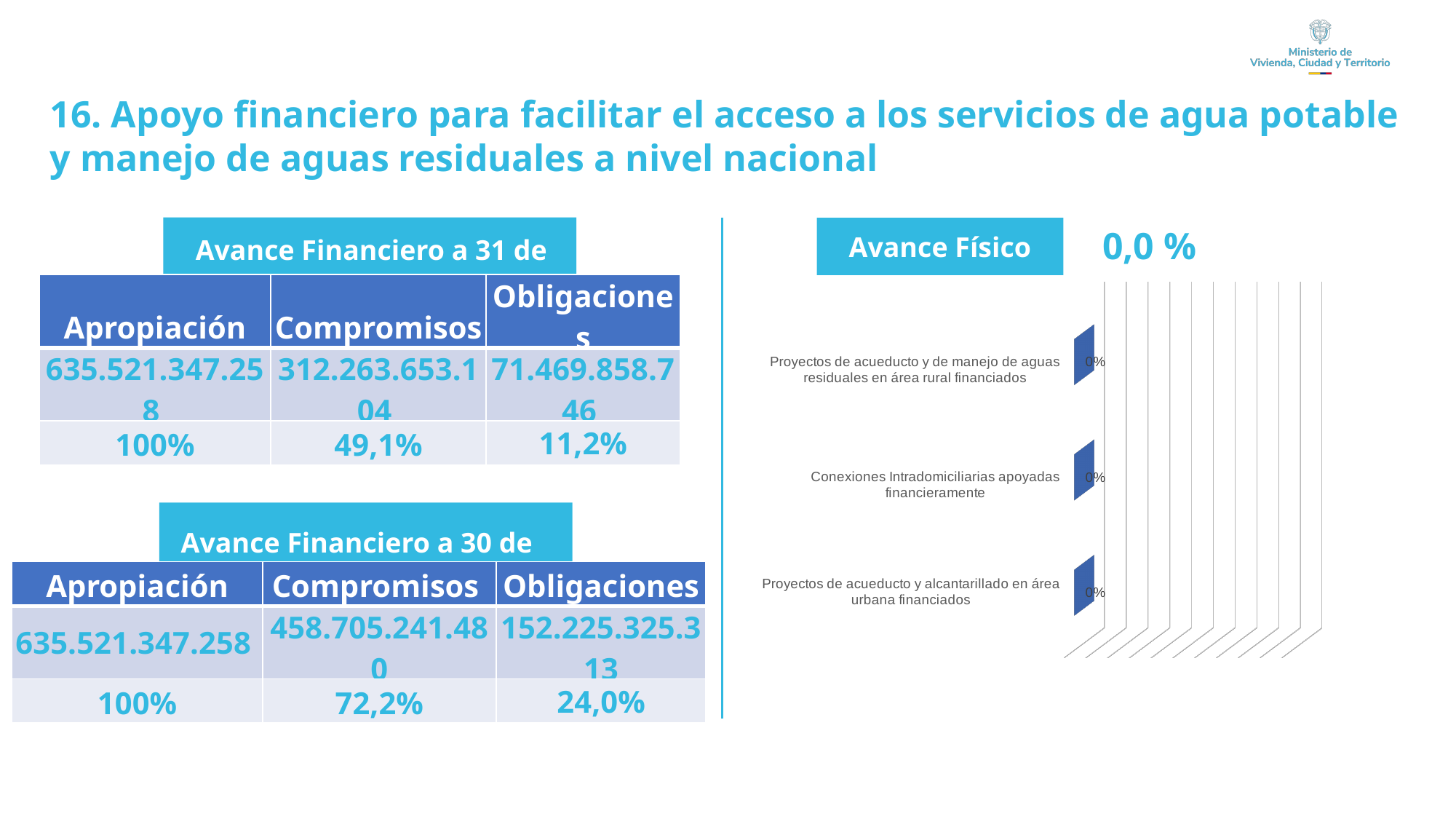
What is the title of the bar chart on the right side of the slide? Avance Físico What kind of chart is shown under the heading "Avance Físico"? bar chart In the "Avance Físico" chart, what is the value for "Proyectos de acueducto y alcantarillado en área urbana financiados"? 0% How many categories does the "Avance Físico" bar chart show? 3 In the "Avance Físico" chart, what is the value for "Proyectos de acueducto y de manejo de aguas residuales en área rural financiados"? 0% In the "Avance Físico" chart, what is the difference between the value for "Conexiones Intradomiciliarias apoyadas financieramente" and the value for "Proyectos de acueducto y alcantarillado en área urbana financiados"? 0% In the "Avance Físico" chart, what is the value for "Conexiones Intradomiciliarias apoyadas financieramente"? 0% What overall percentage is printed next to the "Avance Físico" chart title? 0,0 %